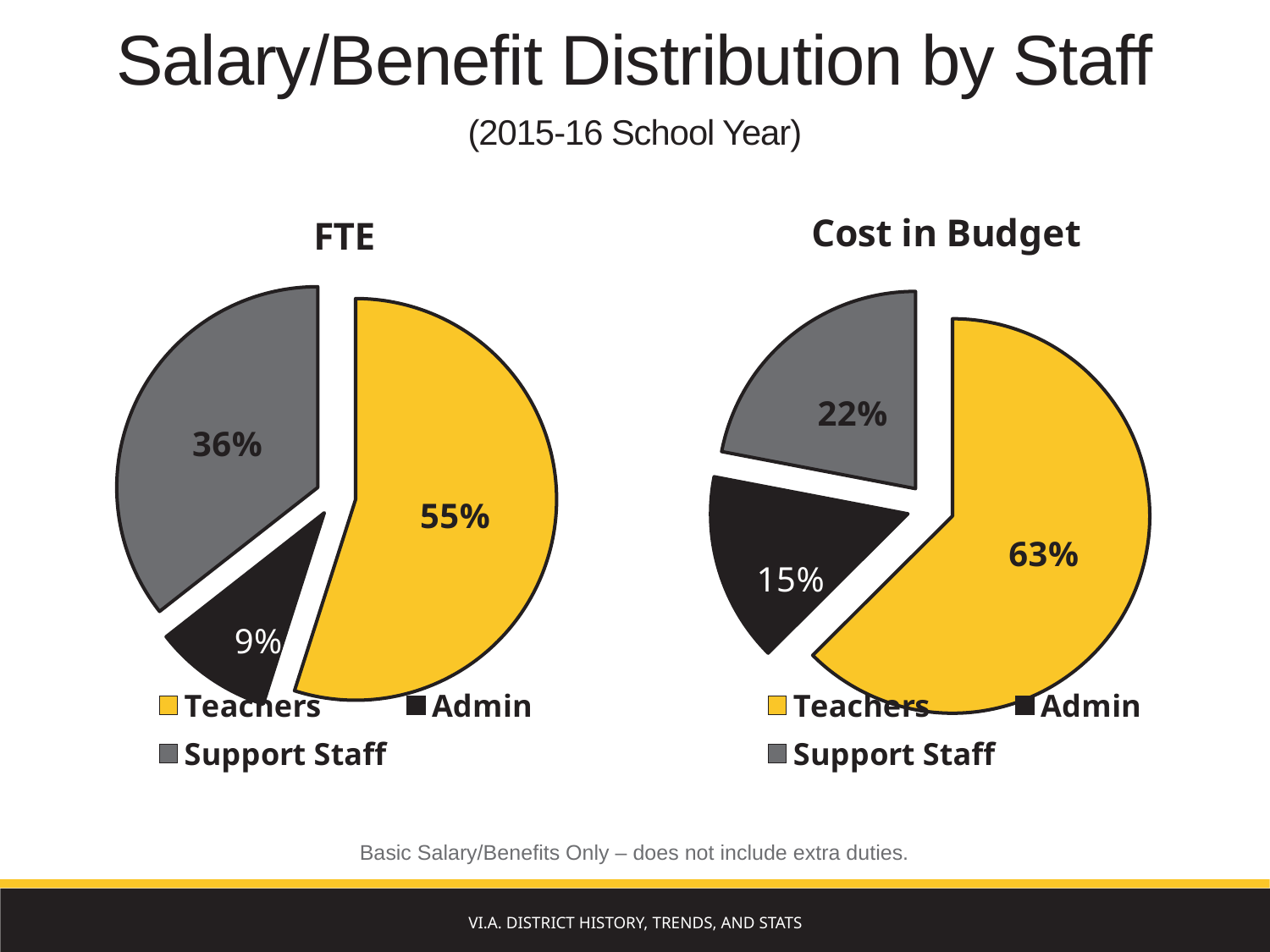
What kind of chart is the Cost in Budget chart? Pie chart In the FTE chart, what is the value for Support Staff? 36% In the Cost in Budget chart, what share of the pie does Support Staff account for? 22% In the Cost in Budget chart, which category has the largest slice? Teachers In the FTE chart, what is the value for Admin? 9% In the Cost in Budget chart, what is the value for Teachers? 63% In the FTE chart, which category has the smallest slice? Admin In the FTE chart, what share of the pie do Teachers account for? 55% In the FTE chart, which is larger, the Support Staff slice or the Admin slice? Support Staff In the Cost in Budget chart, what is the difference between the Teachers and Support Staff values? 41% How many categories does the legend of the FTE chart list? 3 In the Cost in Budget chart, what is the value for Admin? 15%